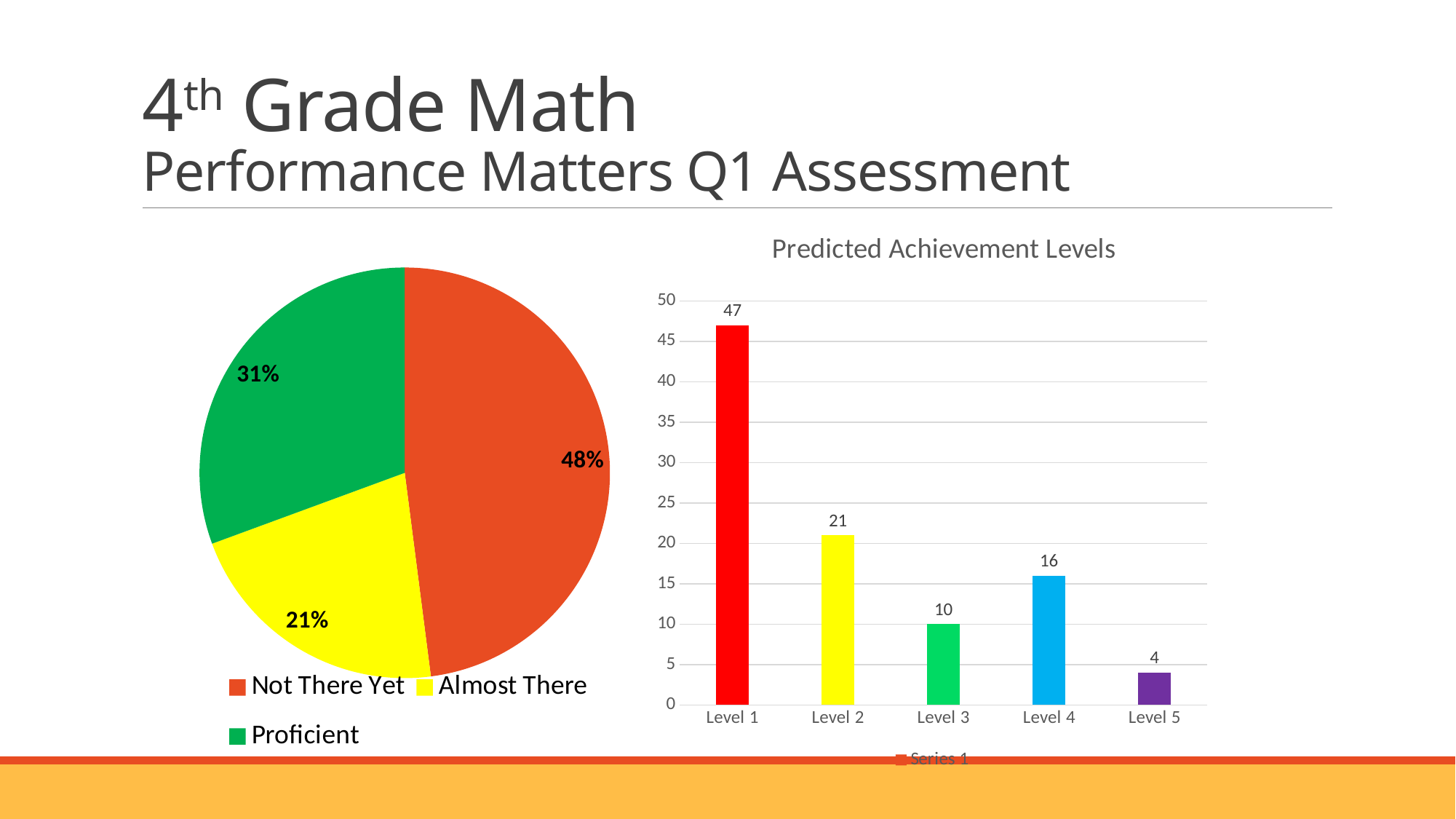
In the Predicted Achievement Levels chart, which level has the lowest value? Level 5 In the Predicted Achievement Levels chart, which is larger, the value for Level 3 or the value for Level 4? Level 4 What kind of chart is the Predicted Achievement Levels chart? Bar chart In the pie chart on the left, what share of the pie is labelled Almost There? 21% In the pie chart on the left, what share of the pie is labelled Proficient? 31% In the pie chart on the left, which category has the smallest slice? Almost There In the pie chart on the left, which category has the largest slice? Not There Yet In the pie chart on the left, how many slices are there? 3 In the Predicted Achievement Levels chart, what is the value for Level 1? 47 In the Predicted Achievement Levels chart, what is the difference between the values for Level 2 and Level 3? 11 In the pie chart on the left, what share of the pie is labelled Not There Yet? 48% In the Predicted Achievement Levels chart, what is the value for Level 4? 16